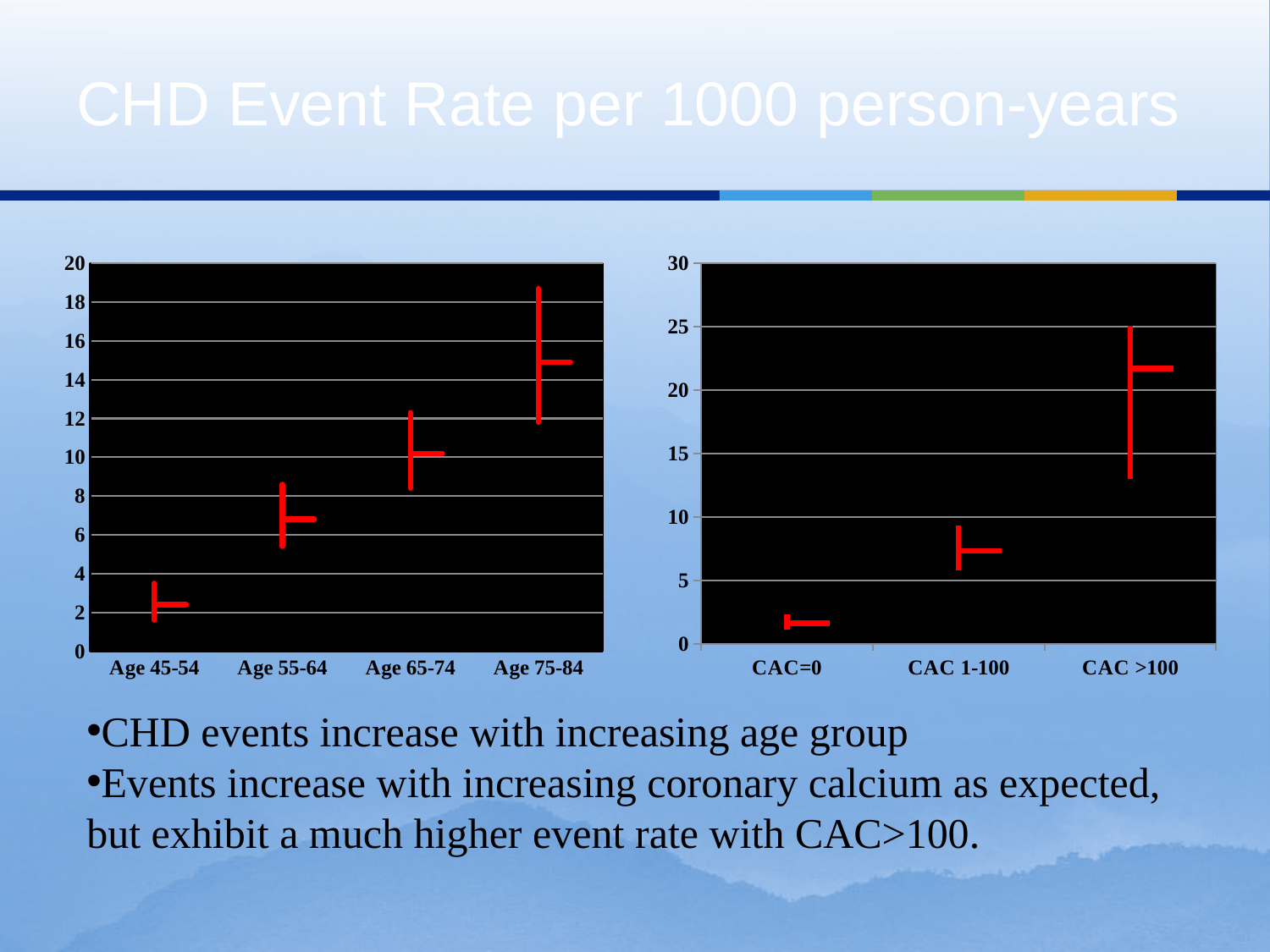
In the left chart, do the event rates rise or fall as the age group increases along the x axis? rise What is the title of the slide containing the two charts? CHD Event Rate per 1000 person-years In the left chart, how many age groups are shown on the x axis? 4 In the left chart, is the value for Age 75-84 greater or less than 14? greater In the right chart, how many CAC categories are shown on the x axis? 3 In the right chart, which CAC category has the lowest event rate? CAC=0 In the left chart, which age group has the highest CHD event rate? Age 75-84 In the right chart, which CAC category has the highest event rate? CAC >100 In the right chart, is the value for CAC >100 greater or less than 20? greater In the right chart, is the value for CAC 1-100 greater or less than 10? less In the left chart, which age group has the lowest CHD event rate? Age 45-54